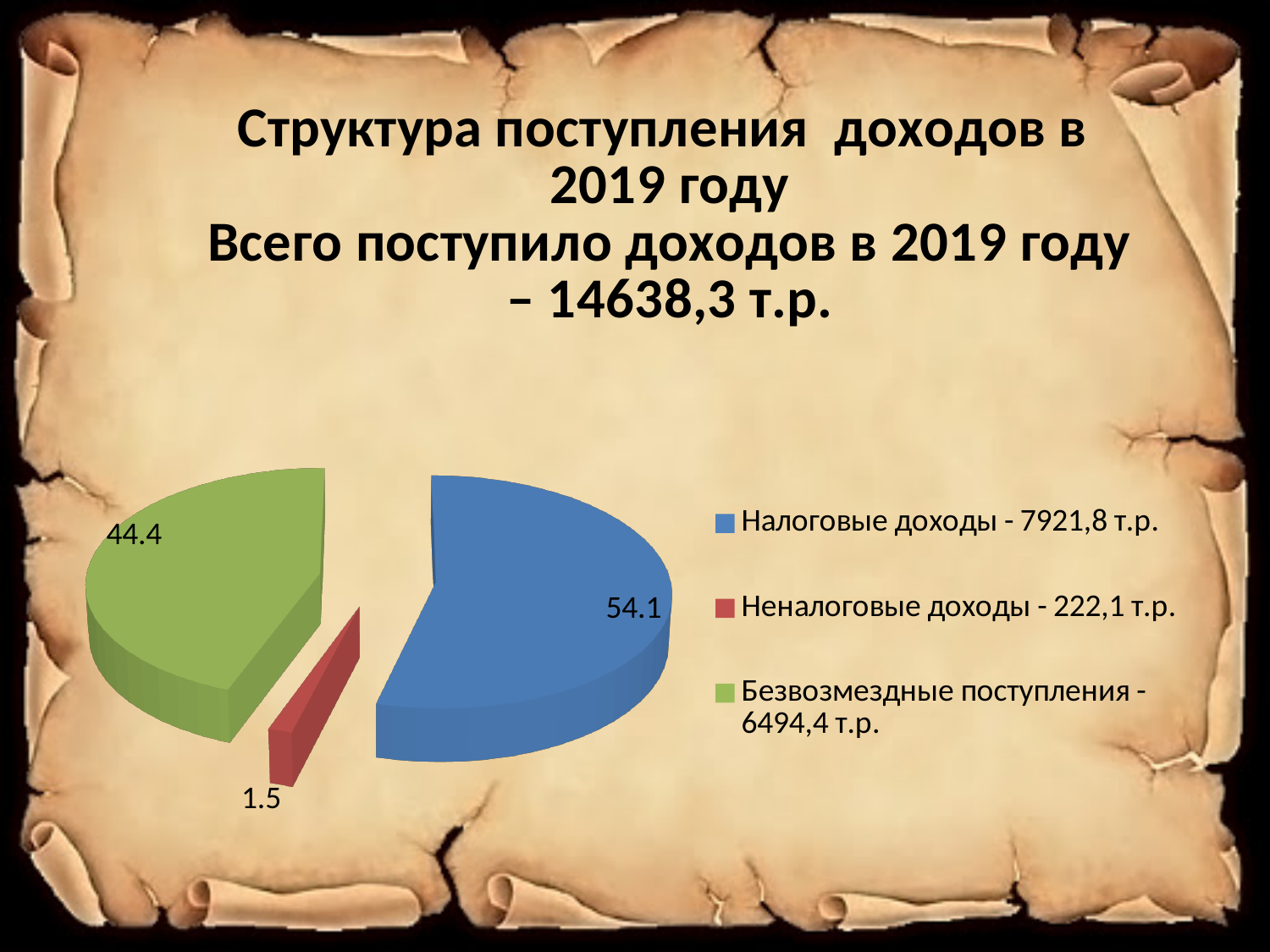
How many slices does the pie chart have? 3 Which category has the largest slice of the pie? Налоговые доходы Which category has the smallest slice of the pie? Неналоговые доходы What percentage share is labelled on the slice for Безвозмездные поступления? 44.4 What percentage share is labelled on the slice for Налоговые доходы? 54.1 What percentage share is labelled on the slice for Неналоговые доходы? 1.5 What colour is the slice for Безвозмездные поступления? green According to the legend, what amount in т.р. corresponds to Неналоговые доходы? 222,1 т.р. What is the difference in percentage points between the Налоговые доходы slice and the Безвозмездные поступления slice? 9.7 How many entries does the legend list? 3 What kind of chart is shown on the slide? pie chart Which slice is larger: Безвозмездные поступления or Неналоговые доходы? Безвозмездные поступления